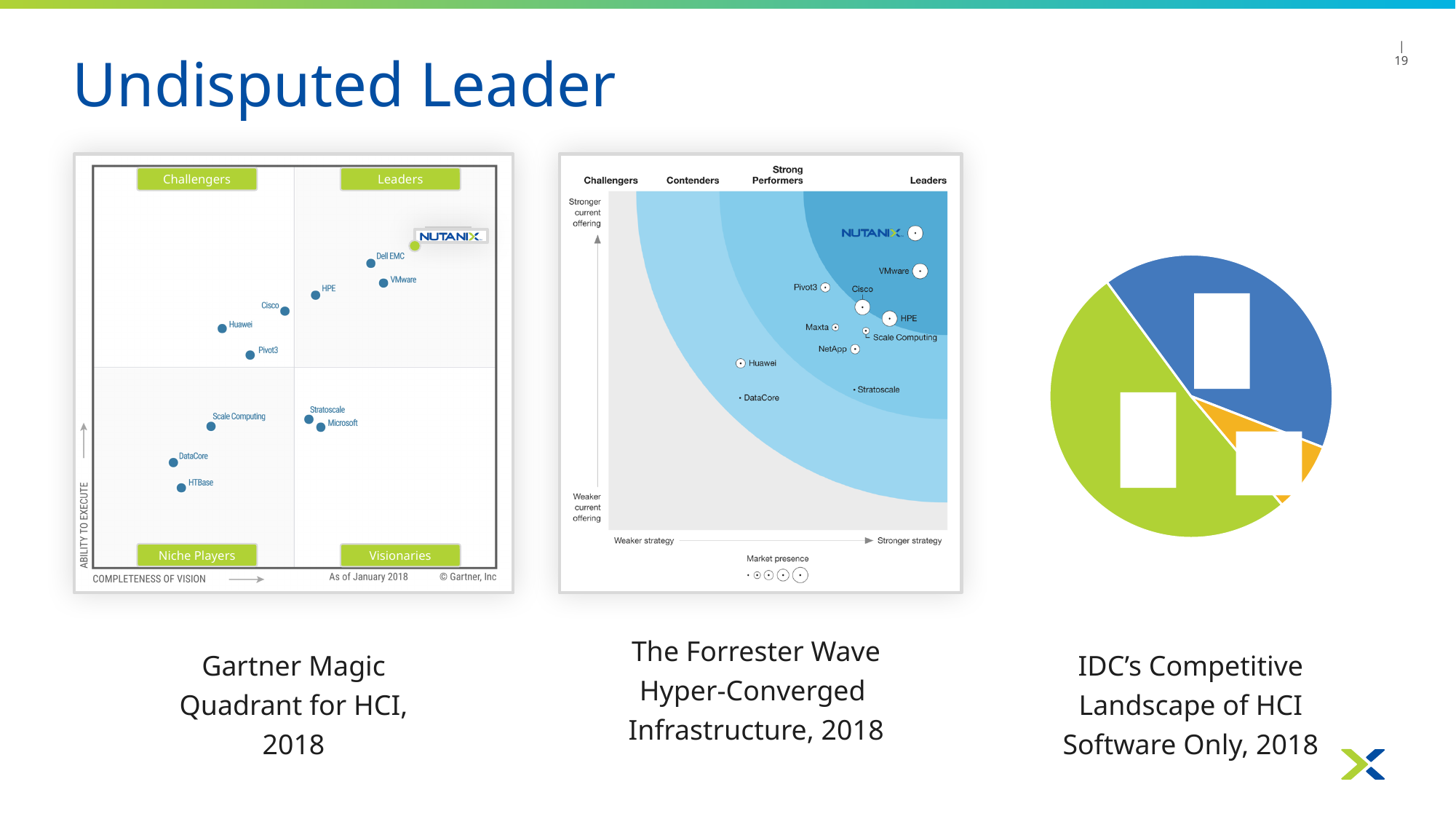
What kind of chart is the Gartner Magic Quadrant for HCI, 2018 on the left? scatter chart What date is the Gartner Magic Quadrant for HCI stated to be as of? As of January 2018 How many vendors are plotted in The Forrester Wave Hyper-Converged Infrastructure, 2018 chart? 11 How many vendors are plotted in the Gartner Magic Quadrant for HCI, 2018? 12 In The Forrester Wave Hyper-Converged Infrastructure, 2018 chart, which vendor has the strongest current offering? Nutanix In the IDC's Competitive Landscape of HCI Software Only, 2018 pie chart, which colour slice is the largest? green In the Gartner Magic Quadrant for HCI, 2018, which vendor has the lowest ability to execute? HTBase In The Forrester Wave Hyper-Converged Infrastructure, 2018 chart, which has the stronger strategy, Huawei or Nutanix? Nutanix In the Gartner Magic Quadrant for HCI, 2018, which quadrant is Nutanix placed in? Leaders In the Gartner Magic Quadrant for HCI, 2018, which quadrant is Microsoft placed in? Visionaries In the Gartner Magic Quadrant for HCI, 2018, which vendor has the highest ability to execute? Nutanix In The Forrester Wave Hyper-Converged Infrastructure, 2018 chart, which vendor has the weakest current offering? DataCore